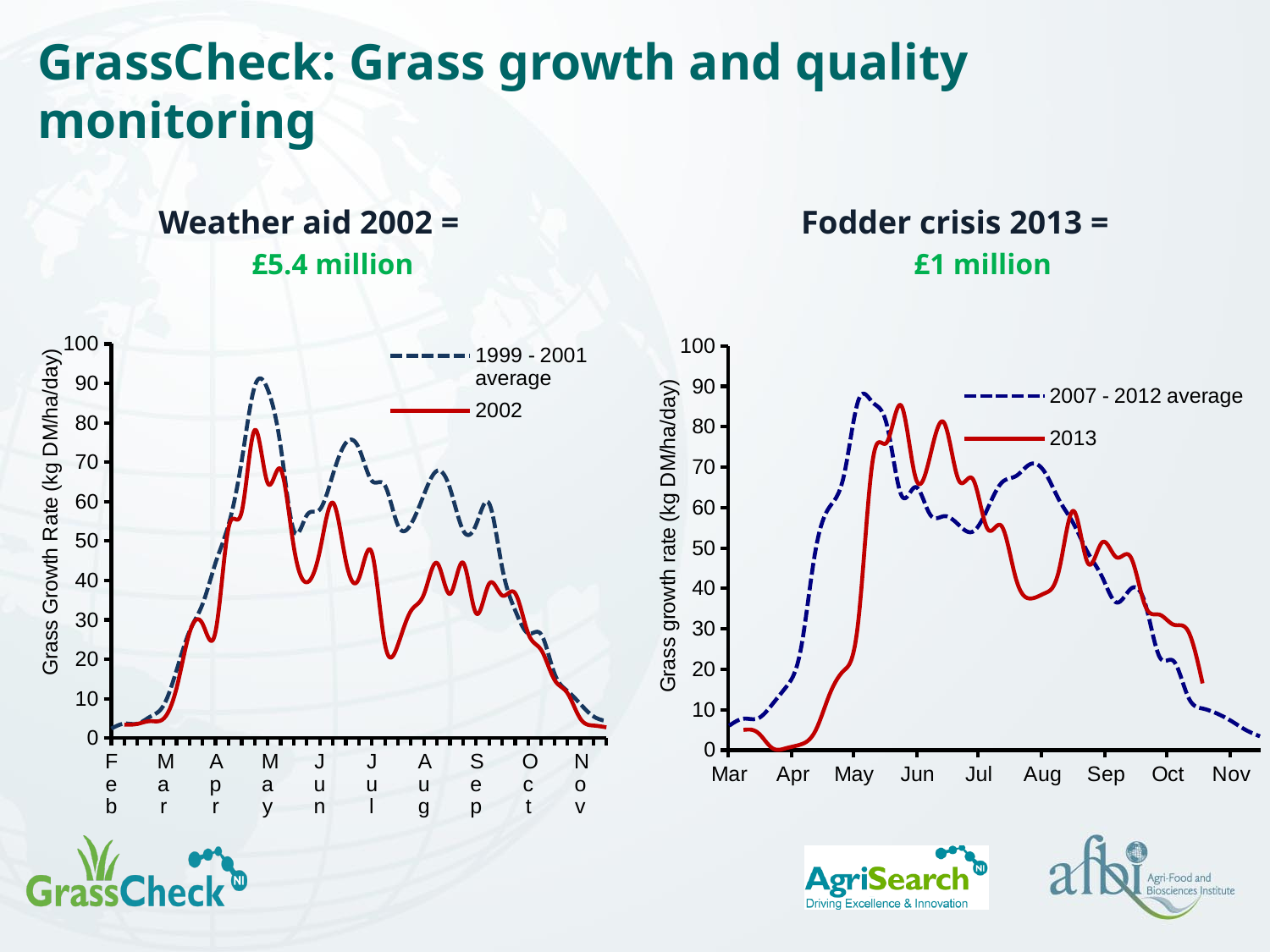
How many months are labelled on the x axis of the right chart (Fodder crisis 2013)? 9 How many series does the legend of the right chart (Fodder crisis 2013) list? 2 In the right chart (Fodder crisis 2013), does the 2013 series rise or fall from September to November? Fall In the right chart (Fodder crisis 2013), which series is higher at the start of May: 2007 - 2012 average or 2013? 2007 - 2012 average In the left chart (Weather aid 2002), is the peak value of the 1999 - 2001 average in May greater or less than 80? greater In the left chart (Weather aid 2002), is the lowest value of the 2002 series in July greater or less than 30? less In the right chart (Fodder crisis 2013), is the value of the 2013 series at the start of April greater or less than 10? less What kind of chart is the left chart (Weather aid 2002)? Line chart In the left chart (Weather aid 2002), what are the two series named in the legend? 1999 - 2001 average and 2002 How many months are labelled on the x axis of the left chart (Weather aid 2002)? 10 In the left chart (Weather aid 2002), which series reaches the higher peak in May: 1999 - 2001 average or 2002? 1999 - 2001 average